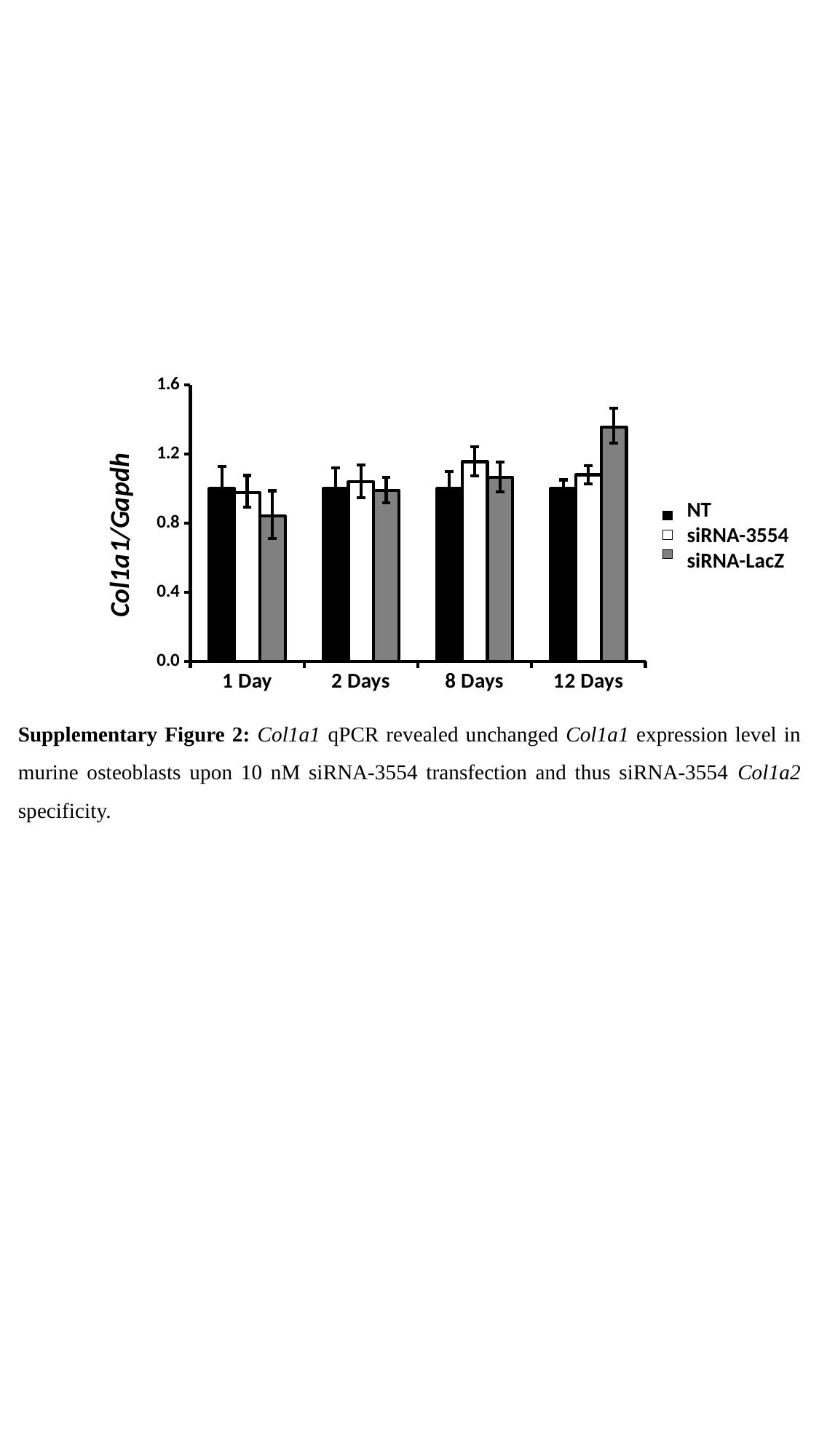
How many series does the chart's legend list? 3 Is the value for siRNA-LacZ at 1 Day greater or less than 1.2? less Which series has the highest bar at 12 Days? siRNA-LacZ Which series has the lowest bar at 1 Day? siRNA-LacZ Which bar is the tallest in the whole chart? siRNA-LacZ at 12 Days Does the siRNA-LacZ series rise or fall from 1 Day to 12 Days? rise Is the value for siRNA-LacZ at 12 Days greater or less than 1.2? greater At 12 Days, which is larger: the NT bar or the siRNA-LacZ bar? siRNA-LacZ Which series is shown with grey bars in the chart? siRNA-LacZ What is the label of the y axis of the chart? Col1a1/Gapdh What kind of chart is shown on the slide? bar chart How many time-point categories are shown on the x axis of the chart? 4